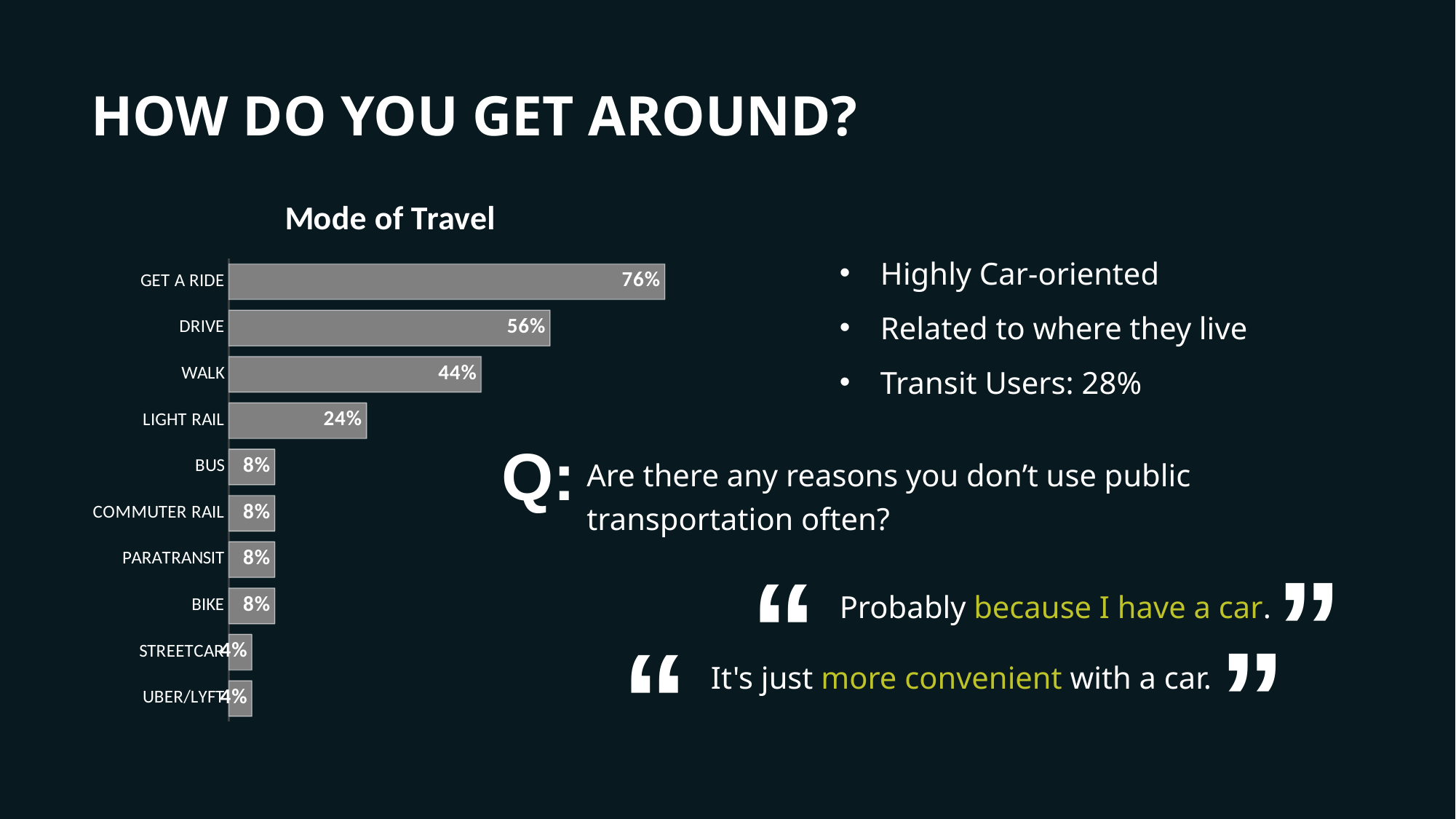
What is the difference between the values for WALK and LIGHT RAIL? 20% What is the value for LIGHT RAIL in the Mode of Travel chart? 24% What is the title of the chart on the slide? Mode of Travel What is the value for BUS in the Mode of Travel chart? 8% Which is larger, the value for WALK or the value for LIGHT RAIL? WALK Which mode of travel has the highest value in the chart? GET A RIDE What is the value for GET A RIDE in the Mode of Travel chart? 76% What is the value for DRIVE in the Mode of Travel chart? 56% What is the difference between the values for GET A RIDE and DRIVE? 20% Which is larger, the value for DRIVE or the value for GET A RIDE? GET A RIDE What kind of chart is the Mode of Travel chart? Bar chart How many categories are shown in the Mode of Travel chart? 10